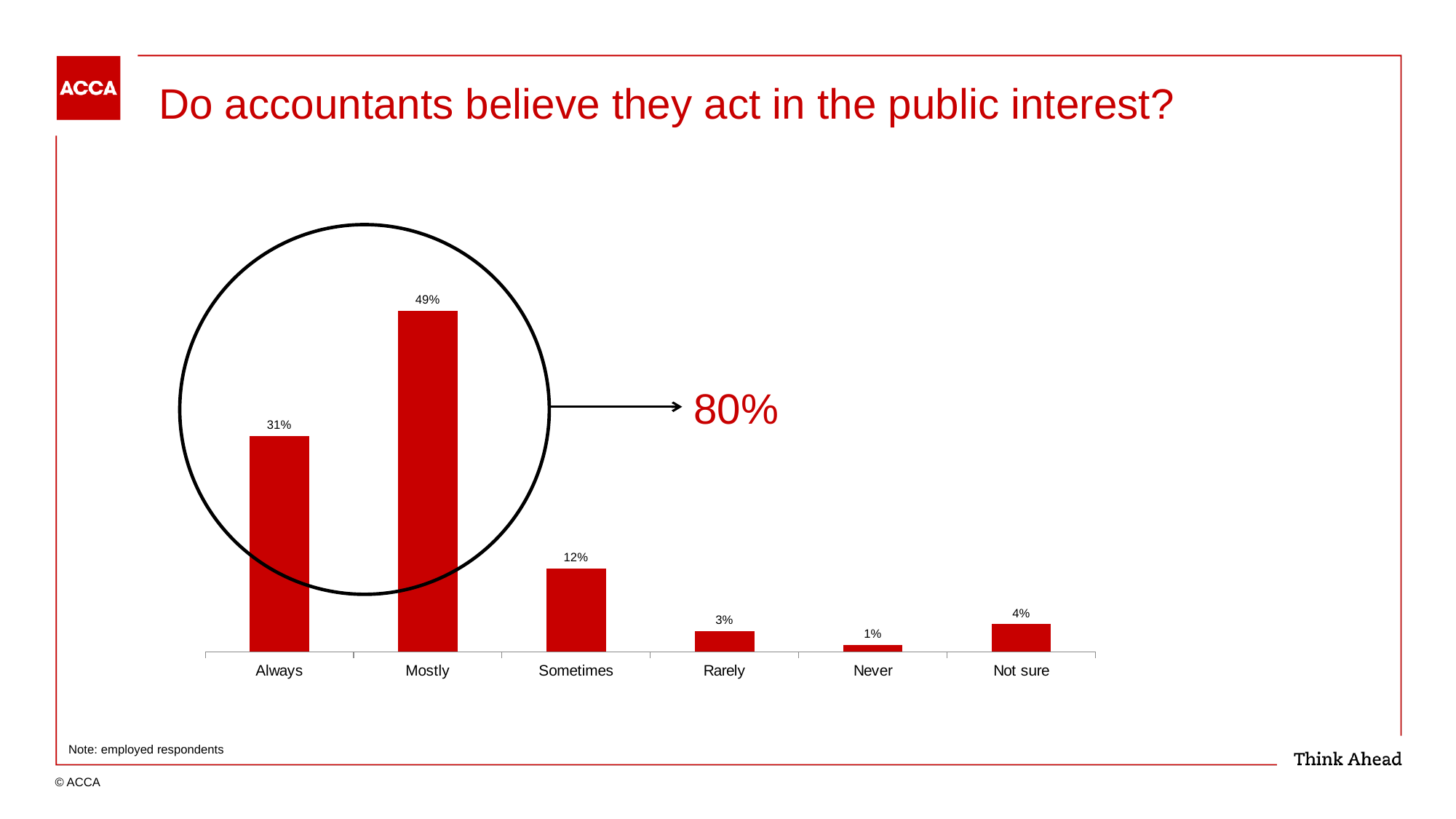
Which category has the highest value? Mostly What is the title of the slide containing the chart? Do accountants believe they act in the public interest? What is the difference between the values for 'Mostly' and 'Always'? 18% What percentage of respondents answered 'Mostly'? 49% What percentage of respondents answered 'Always'? 31% What is the value for 'Not sure'? 4% Which category has the lowest value? Never Which is larger, the value for 'Rarely' or the value for 'Not sure'? Not sure What is the value for 'Sometimes'? 12% What kind of chart is shown on the slide? Bar chart How many categories are shown on the x axis? 6 What is the combined total of the 'Always' and 'Mostly' values, as highlighted by the circle annotation? 80%